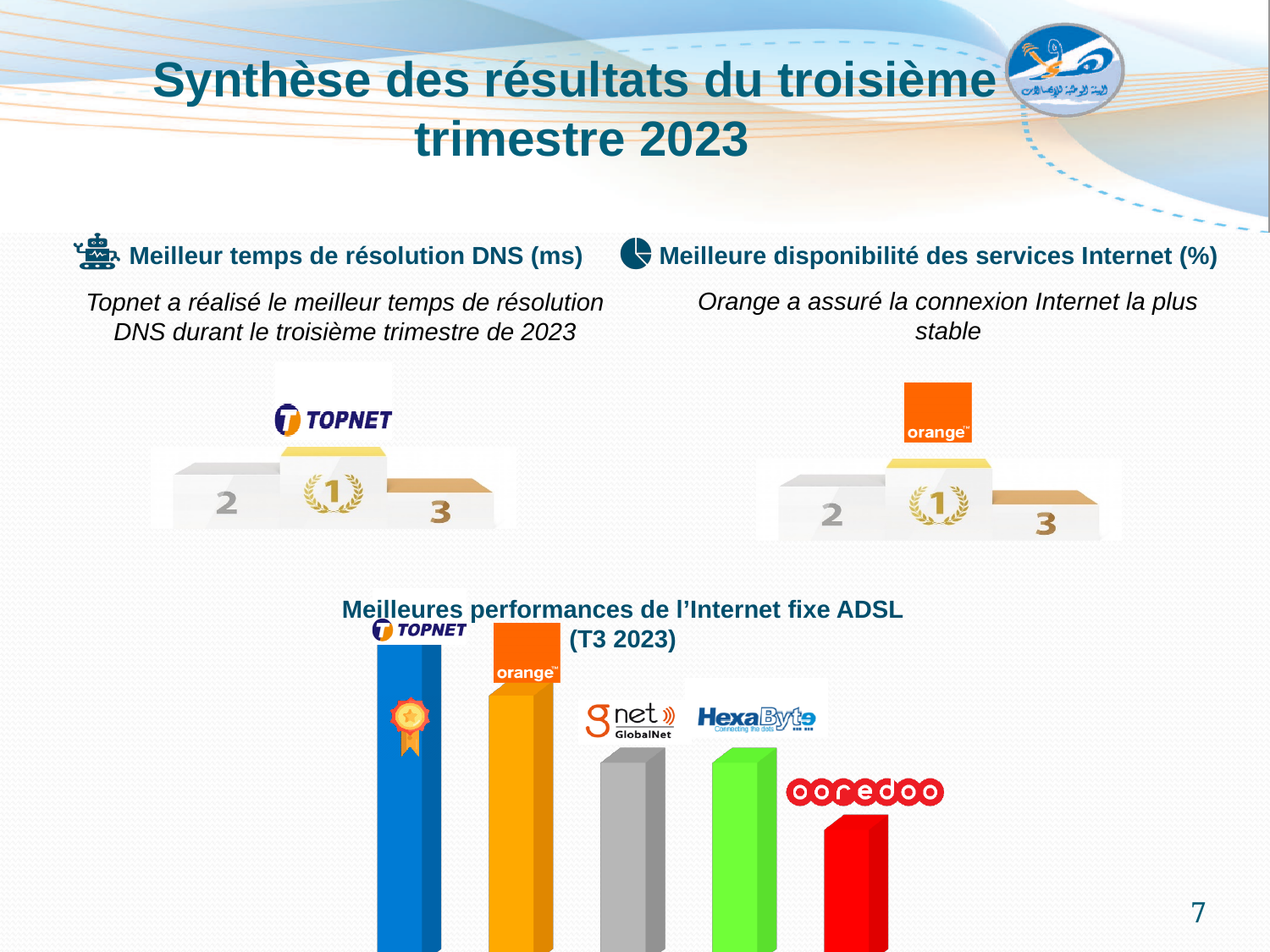
In the 'Meilleures performances de l'Internet fixe ADSL (T3 2023)' chart, which provider is ranked second (second tallest bar)? Orange In the 'Meilleures performances de l'Internet fixe ADSL (T3 2023)' chart, what colour is the Topnet bar? blue In the 'Meilleures performances de l'Internet fixe ADSL (T3 2023)' chart, which provider has the shortest bar? Ooredoo What kind of chart is shown at the bottom of the slide under 'Meilleures performances de l'Internet fixe ADSL (T3 2023)'? bar chart In the 'Meilleures performances de l'Internet fixe ADSL (T3 2023)' chart, which bar is taller: Orange or GlobalNet? Orange In the 'Meilleures performances de l'Internet fixe ADSL (T3 2023)' chart, which bar is taller: Topnet or Orange? Topnet In the 'Meilleures performances de l'Internet fixe ADSL (T3 2023)' chart, which provider has the tallest bar? Topnet In the 'Meilleures performances de l'Internet fixe ADSL (T3 2023)' chart, how many bars (providers) are shown? 5 What is the title of the bar chart at the bottom of the slide? Meilleures performances de l'Internet fixe ADSL (T3 2023) In the 'Meilleures performances de l'Internet fixe ADSL (T3 2023)' chart, do the bars rise or fall from left to right? fall